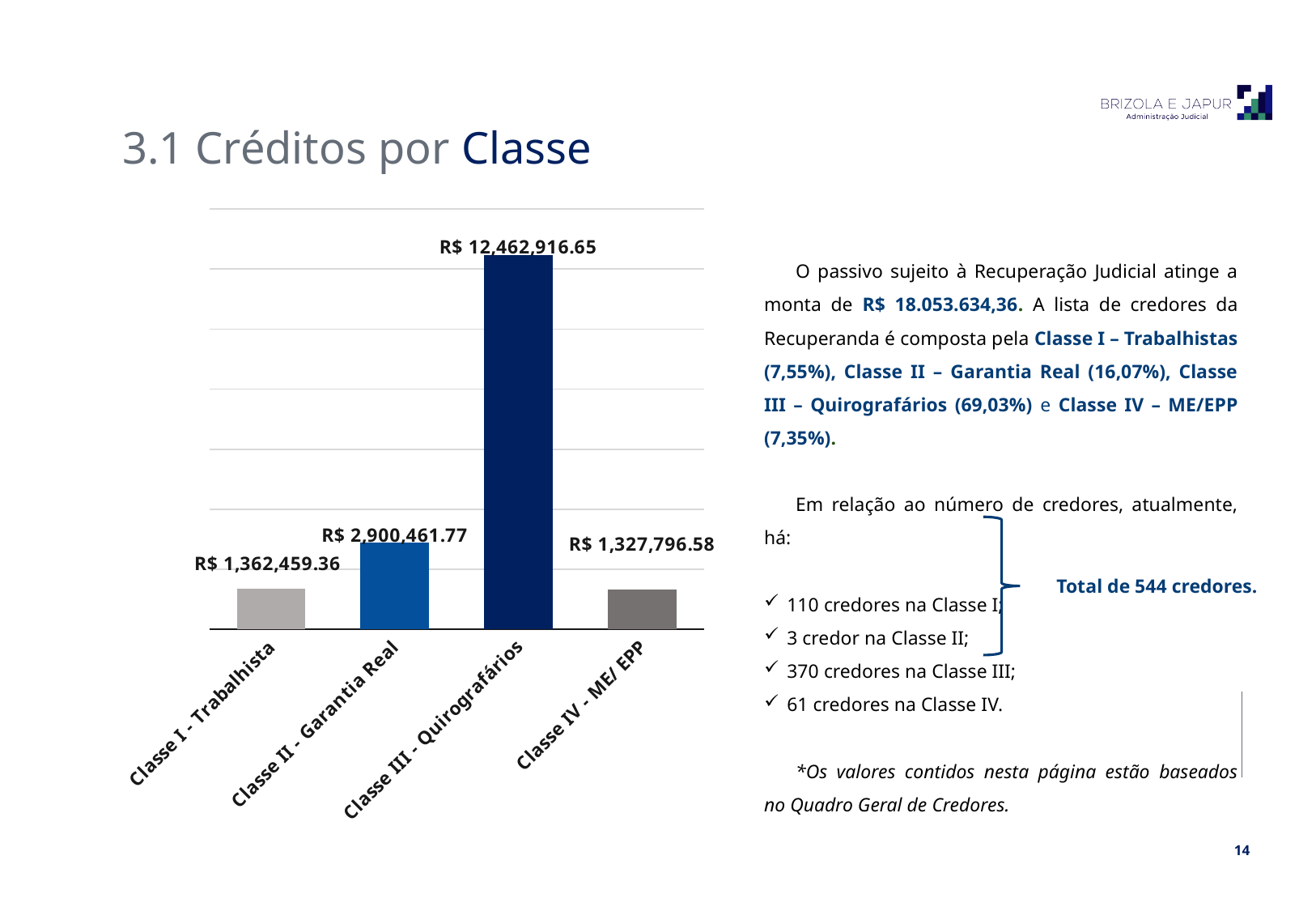
How many classes are shown in the chart? 4 Which class has the highest value? Classe III - Quirografários Which is larger, the value for Classe I - Trabalhista or Classe IV - ME/ EPP? Classe I - Trabalhista What kind of chart is shown on the slide? Bar chart Which class has the lowest value? Classe IV - ME/ EPP What is the value for Classe II - Garantia Real? R$ 2,900,461.77 What is the total of the four values shown in the chart? R$ 18,053,634.36 What is the difference between Classe III - Quirografários and Classe II - Garantia Real? R$ 9,562,454.88 What is the value for Classe I - Trabalhista? R$ 1,362,459.36 What is the difference between Classe II - Garantia Real and Classe I - Trabalhista? R$ 1,538,002.41 What is the value for Classe IV - ME/ EPP? R$ 1,327,796.58 What is the value for Classe III - Quirografários? R$ 12,462,916.65